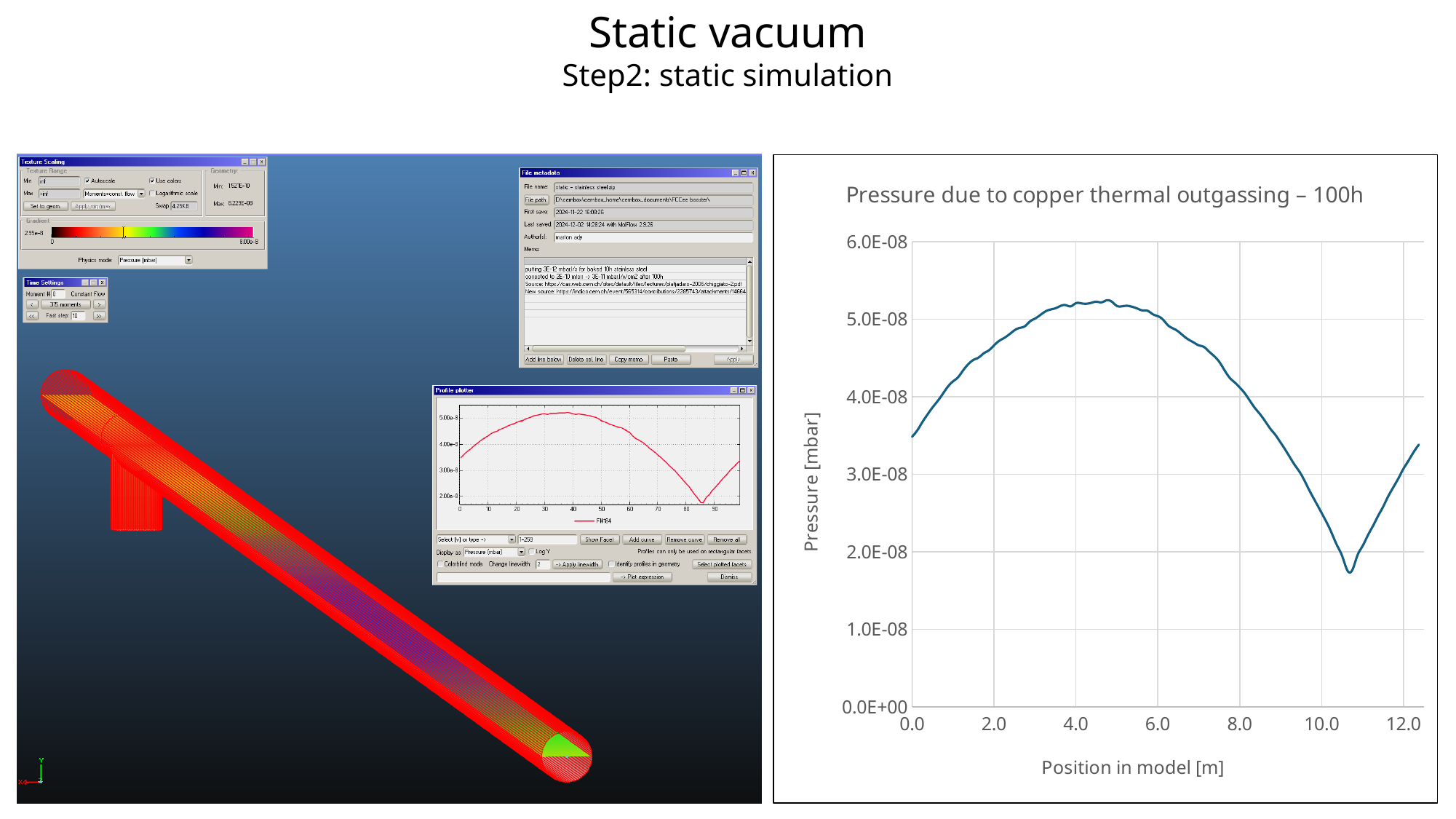
What is the title of the chart on the right side of the slide? Pressure due to copper thermal outgassing – 100h How many data series are plotted in the chart 'Pressure due to copper thermal outgassing – 100h'? 1 What kind of chart is shown on the right side of the slide? line chart In the chart 'Pressure due to copper thermal outgassing – 100h', is the pressure at position 10.0 m greater or less than 3.0E-08 mbar? less In the chart 'Pressure due to copper thermal outgassing – 100h', is the pressure at position 0.0 m greater or less than 3.0E-08 mbar? greater In the chart 'Pressure due to copper thermal outgassing – 100h', is the pressure at position 4.0 m greater or less than 5.0E-08 mbar? greater In the chart 'Pressure due to copper thermal outgassing – 100h', what is the label of the x axis? Position in model [m] In the chart 'Pressure due to copper thermal outgassing – 100h', does the pressure rise or fall as the position increases from 0.0 m to 4.0 m? rise In the chart 'Pressure due to copper thermal outgassing – 100h', is the pressure higher at position 4.0 m or at position 10.0 m? 4.0 m In the chart 'Pressure due to copper thermal outgassing – 100h', does the pressure rise or fall as the position increases from 6.0 m to 10.0 m? fall